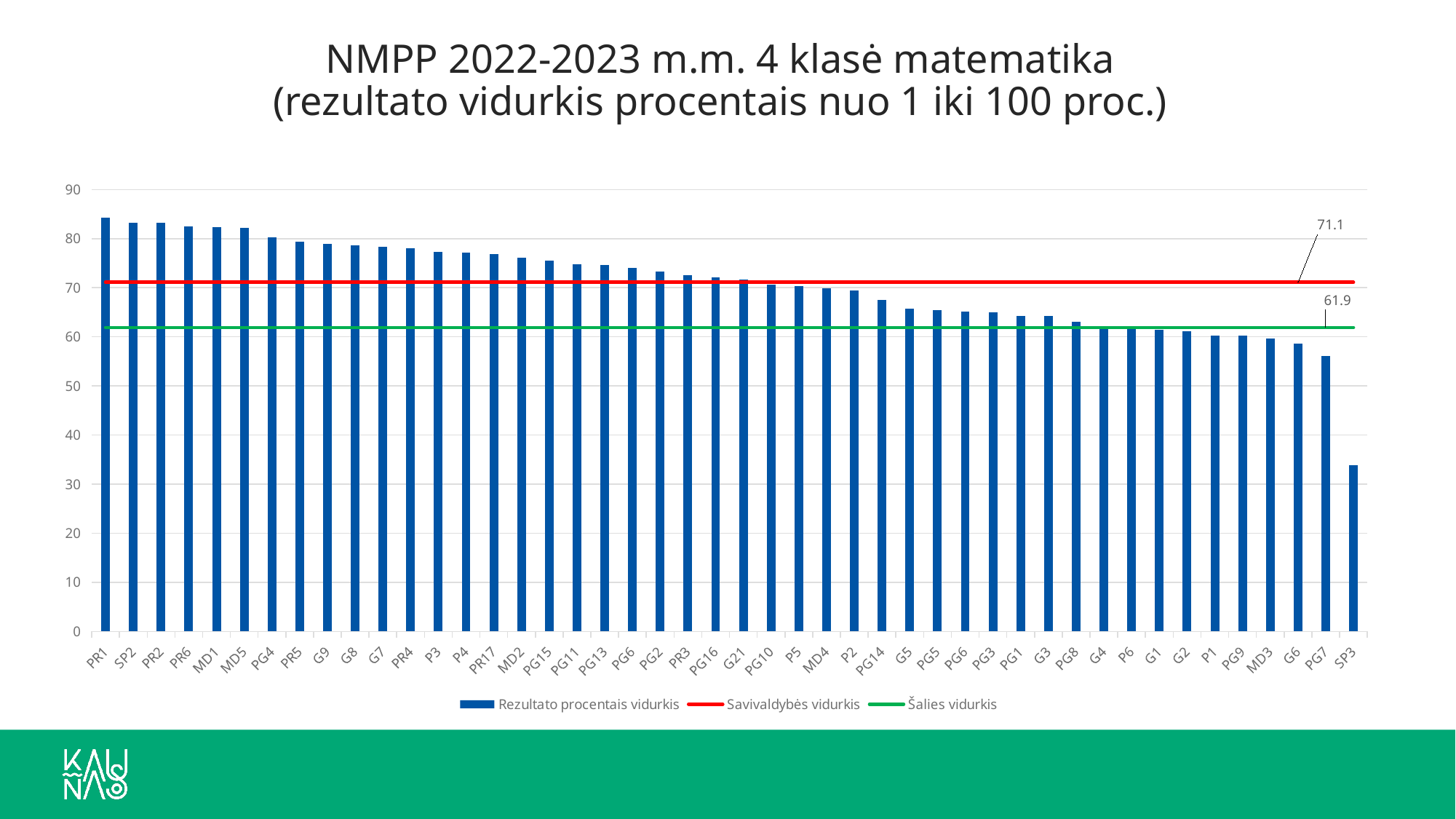
Which is larger, the bar for PR2 or the bar for G6? PR2 What is the difference between the Savivaldybės vidurkis (71.1) and the Šalies vidurkis (61.9)? 9.2 Is the value for SP3 greater or less than 40? less Do the bar values rise or fall from left to right along the x axis? fall Which category has the lowest bar? SP3 What type of chart is shown on the slide? bar chart What is the value of the Savivaldybės vidurkis line? 71.1 Is the value for PR1 greater or less than 80? greater Is the value for PG7 greater or less than 60? less How many series does the legend list? 3 What is the value of the Šalies vidurkis line? 61.9 Which category has the highest bar? PR1